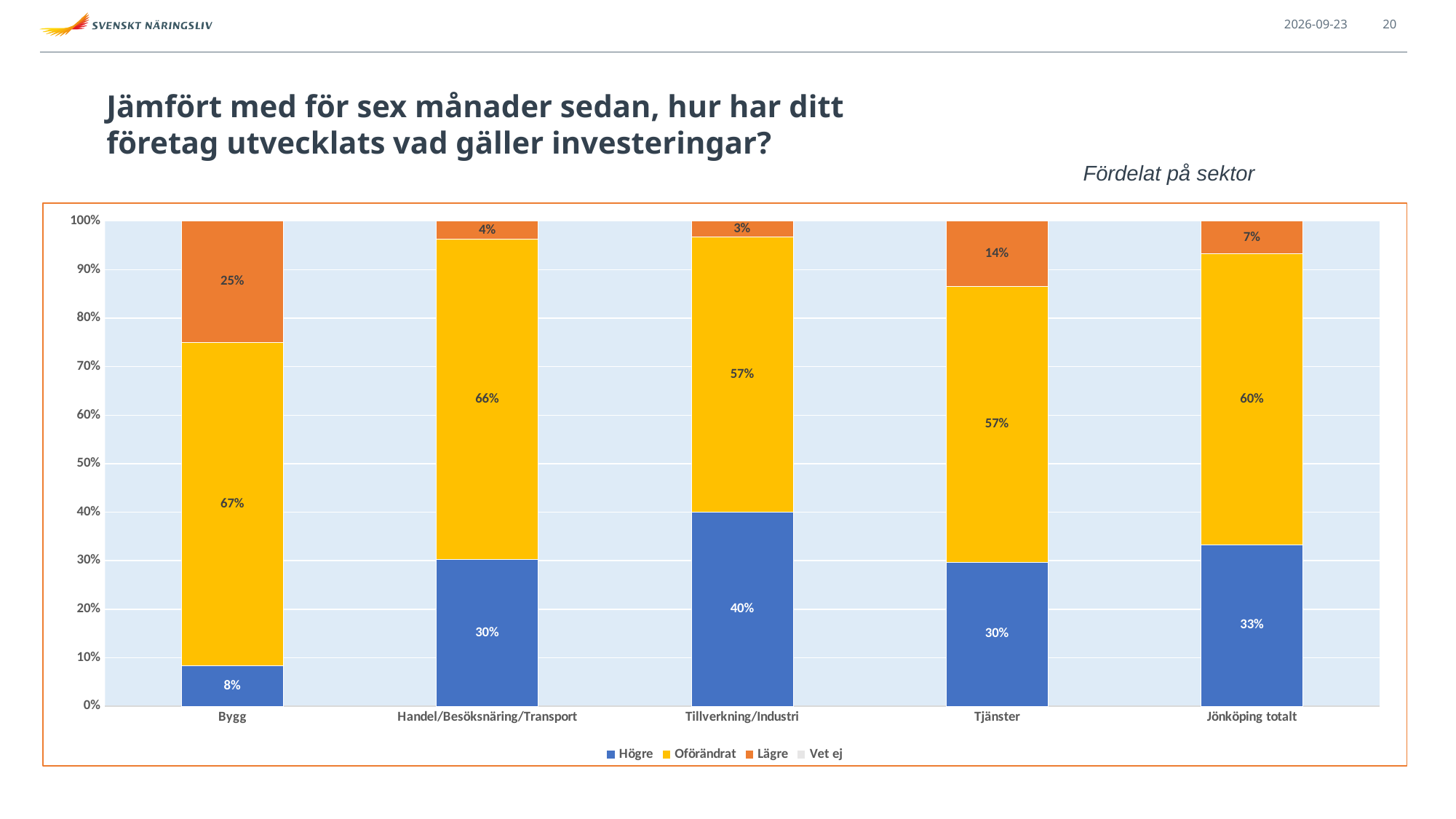
What kind of chart is shown on the slide? Stacked bar chart What is the Lägre value for Tjänster? 14% Which sector has the lowest Högre value? Bygg Which is larger, the Oförändrat value for Handel/Besöksnäring/Transport or for Tjänster? Handel/Besöksnäring/Transport What is the difference between the Lägre values for Bygg and Tjänster? 11 percentage points How many sectors are shown on the x axis? 5 What is the Högre value for Tillverkning/Industri? 40% How many series does the legend list? 4 What is the Lägre value for Bygg? 25% Which sector has the lowest Lägre value? Tillverkning/Industri What is the Oförändrat value for Jönköping totalt? 60% Which sector has the highest Högre value? Tillverkning/Industri